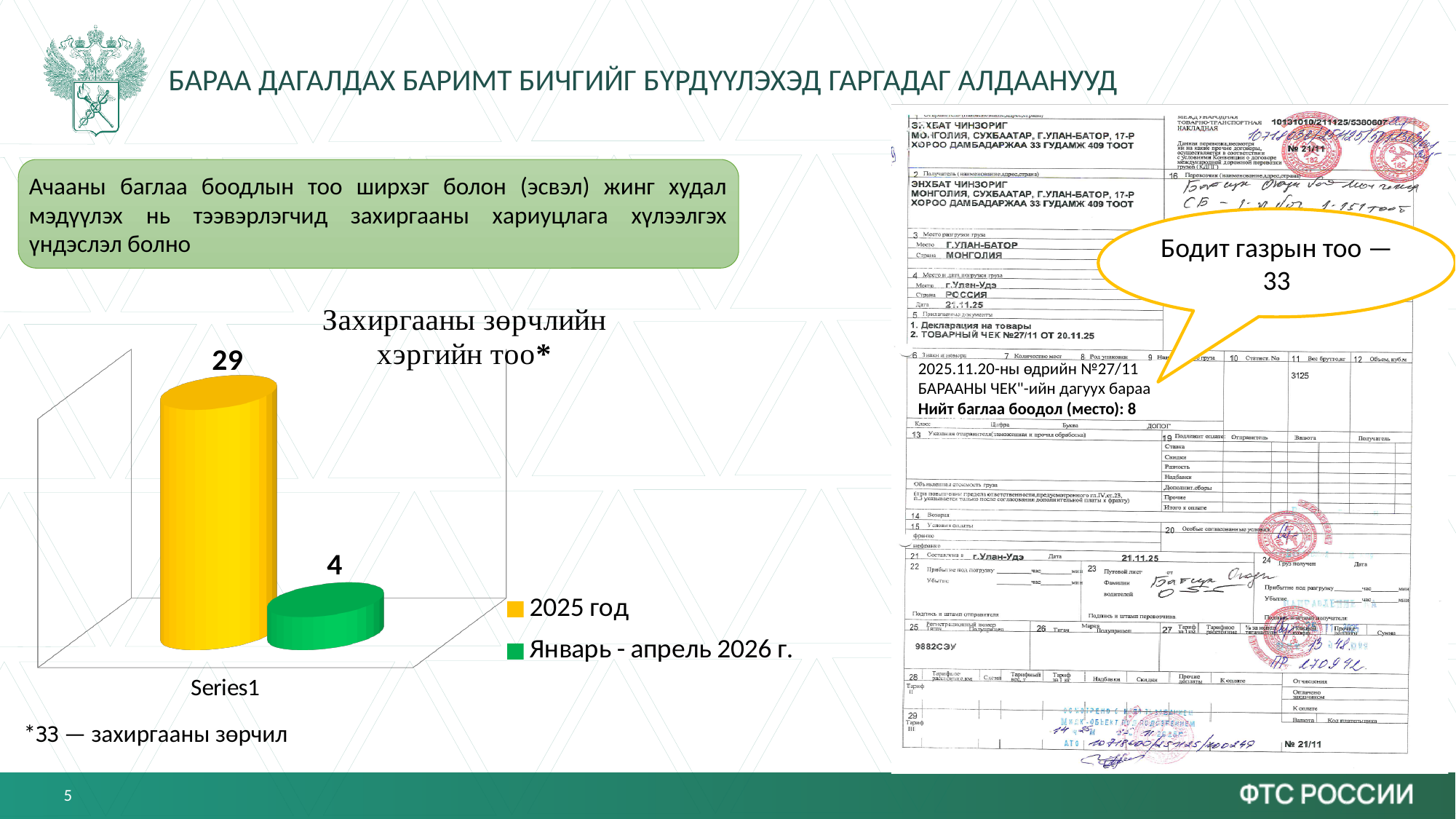
How many bars are plotted in the chart? 2 Which series has the lowest value in the chart? Январь - апрель 2026 г. What colour is the bar for "2025 год" in the chart? Yellow What is the value for the series "Январь - апрель 2026 г." in the chart? 4 What is the sum of the two values shown in the chart? 33 Which series has the highest value in the chart? 2025 год How many series does the chart legend list? 2 What is the difference between the value for "2025 год" and the value for "Январь - апрель 2026 г."? 25 What is the title of the chart? Захиргааны зөрчлийн хэргийн тоо* What is the value for the series "2025 год" in the chart? 29 What kind of chart is shown on the slide? Bar chart Which is larger: the value for "2025 год" or the value for "Январь - апрель 2026 г."? 2025 год